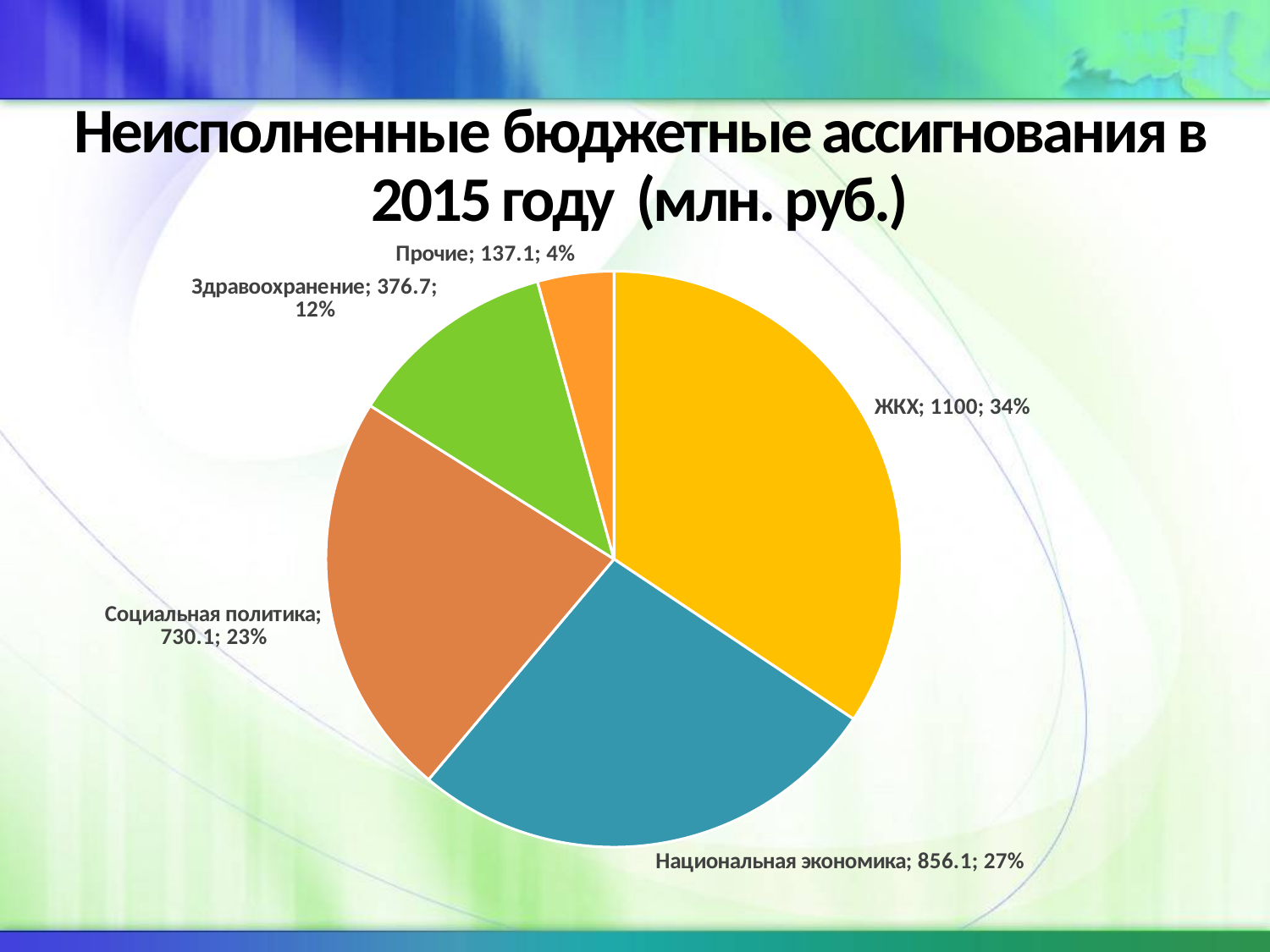
What is the value for Здравоохранение? 376.7 What share of the pie does Национальная экономика take? 27% What is the difference between the values for ЖКХ and Национальная экономика? 243.9 Which category has the smallest slice? Прочие Which is larger, the value for Социальная политика or the value for Здравоохранение? Социальная политика What kind of chart is shown on the slide? pie chart Which category has the largest slice? ЖКХ How many slices does the pie chart have? 5 What is the value for ЖКХ? 1100 What share of the pie does Прочие take? 4% What is the value for Социальная политика? 730.1 What is the title of the chart? Неисполненные бюджетные ассигнования в 2015 году (млн. руб.)